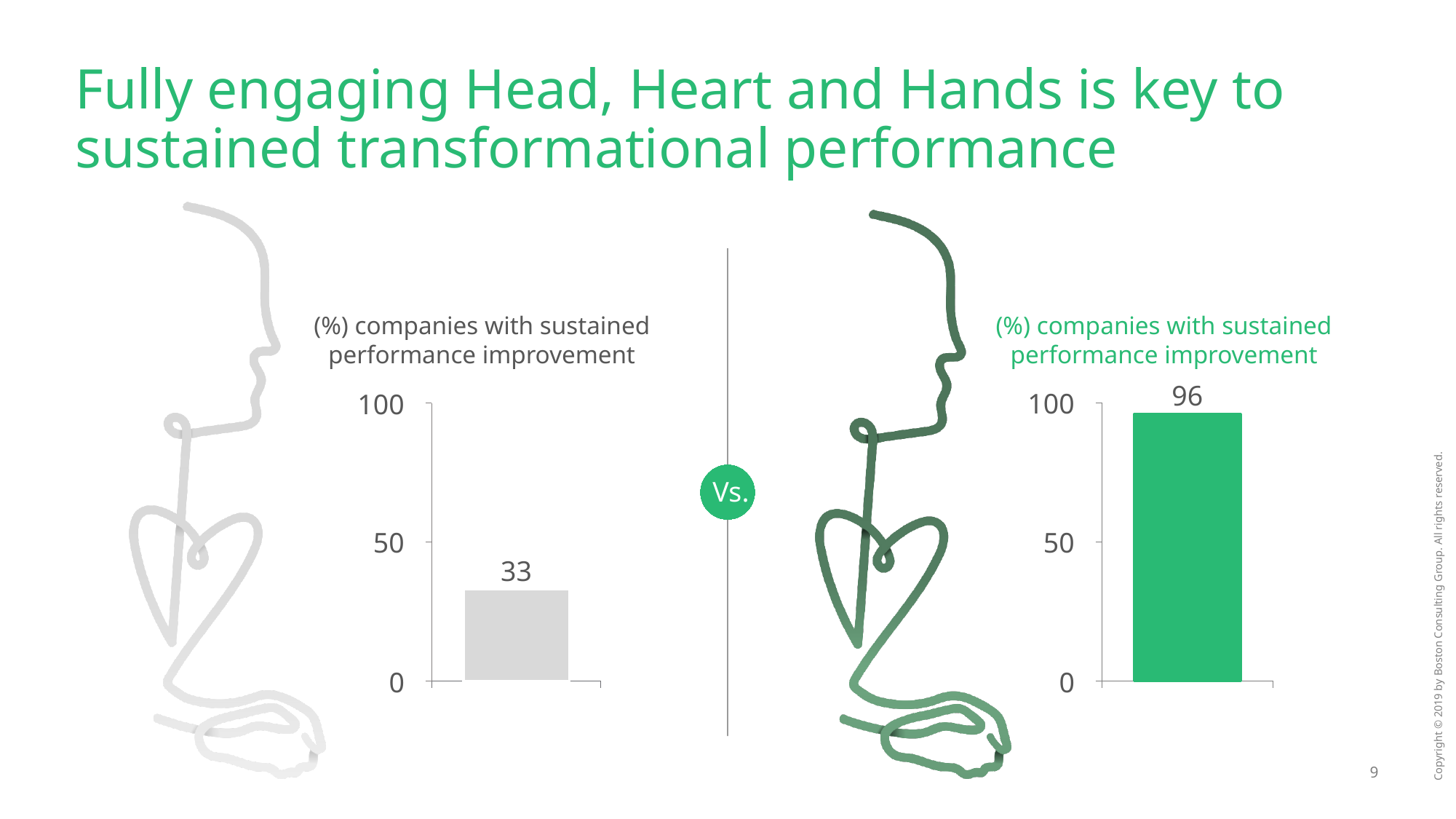
In the right chart, what is the value of the bar? 96 How many bars are plotted in the left chart? 1 How many bars are plotted in the right chart? 1 In the left chart, is the value of the bar greater or less than 50? less What kind of chart is the left chart? bar chart In the left chart, what is the value of the bar? 33 What is the difference between the bar value in the right chart and the bar value in the left chart? 63 In the right chart, is the value of the bar greater or less than 50? greater What is the highest value shown on the vertical axis of the right chart? 100 What colour is the bar in the right chart? green What kind of chart is the right chart? bar chart Which chart shows the larger value, the left chart or the right chart? the right chart